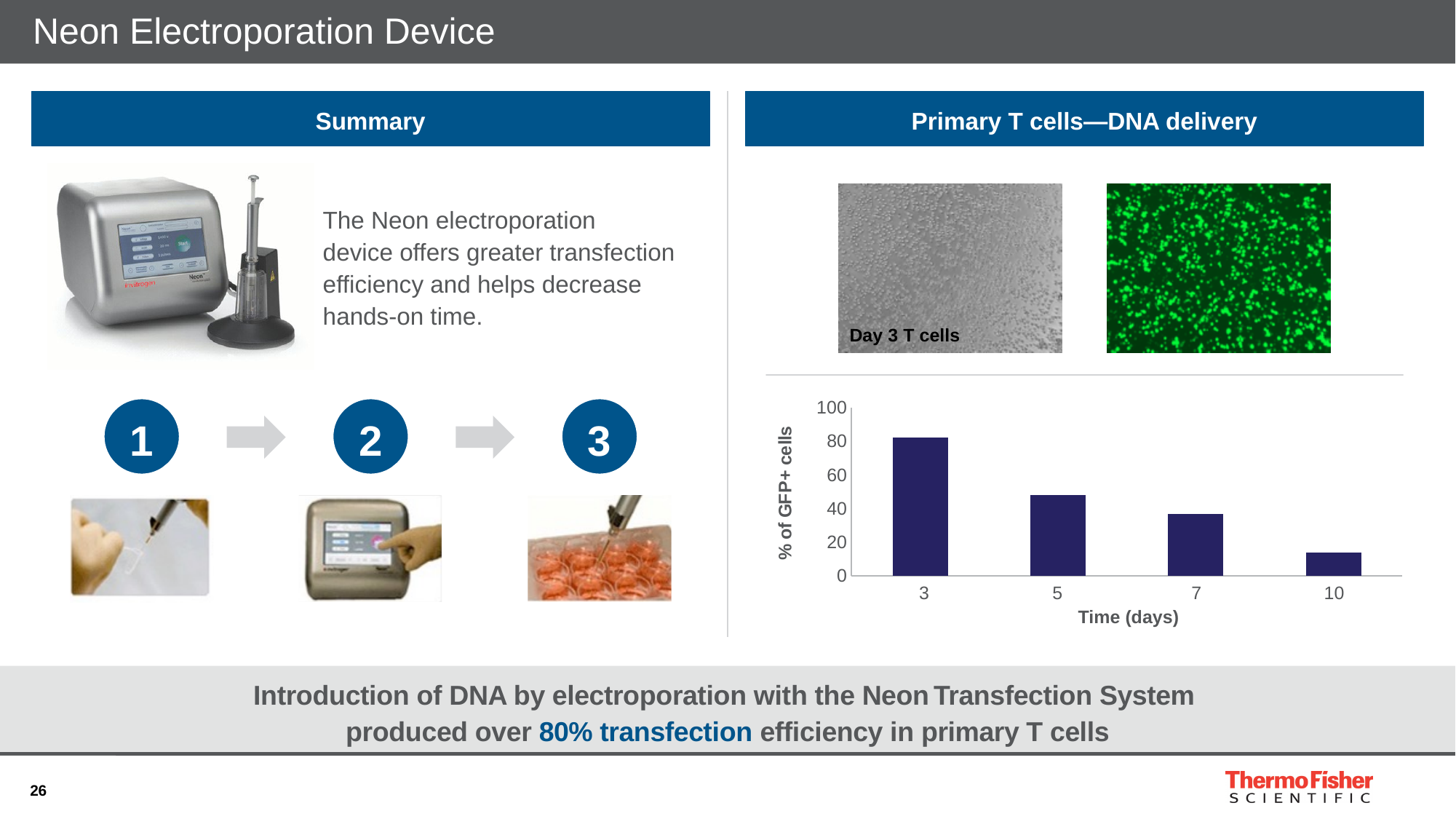
Does the % of GFP+ cells rise or fall as time in days increases? fall How many time points (bars) are plotted in the chart? 4 Is the % of GFP+ cells at day 5 greater or less than 60? less At which time point is the % of GFP+ cells highest? 3 days At which time point is the % of GFP+ cells lowest? 10 days What kind of chart is shown under "Primary T cells—DNA delivery"? bar chart Is the % of GFP+ cells at day 7 greater or less than 20? greater Is the % of GFP+ cells at day 3 greater or less than 60? greater Which has a higher % of GFP+ cells, day 5 or day 7? day 5 What is the label of the chart's y axis? % of GFP+ cells